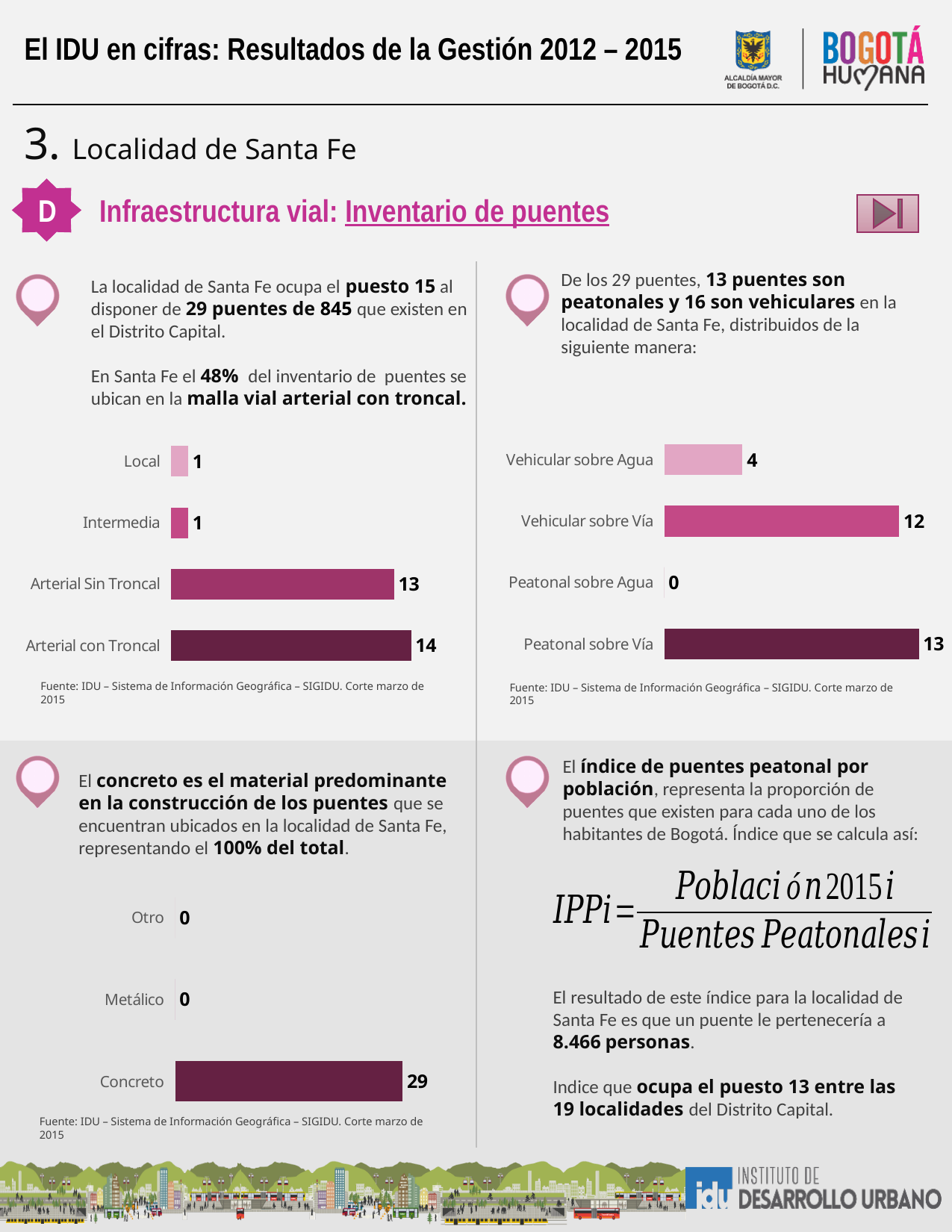
In the top-right chart, which category has the lowest value? Peatonal sobre Agua In the bottom-left chart, what is the value for Concreto? 29 In the top-left chart, what is the difference between Arterial con Troncal and Arterial Sin Troncal? 1 How many categories does the top-left chart show? 4 In the top-right chart, what is the value for Vehicular sobre Vía? 12 In the top-right chart, which is larger, Peatonal sobre Vía or Vehicular sobre Vía? Peatonal sobre Vía In the top-left chart, which category has the highest value? Arterial con Troncal In the bottom-left chart, what is the value for Metálico? 0 How many categories does the bottom-left chart show? 3 In the top-left chart, what is the value for Arterial con Troncal? 14 In the top-right chart, what is the difference between Vehicular sobre Vía and Vehicular sobre Agua? 8 What kind of chart is the bottom-left chart? Bar chart